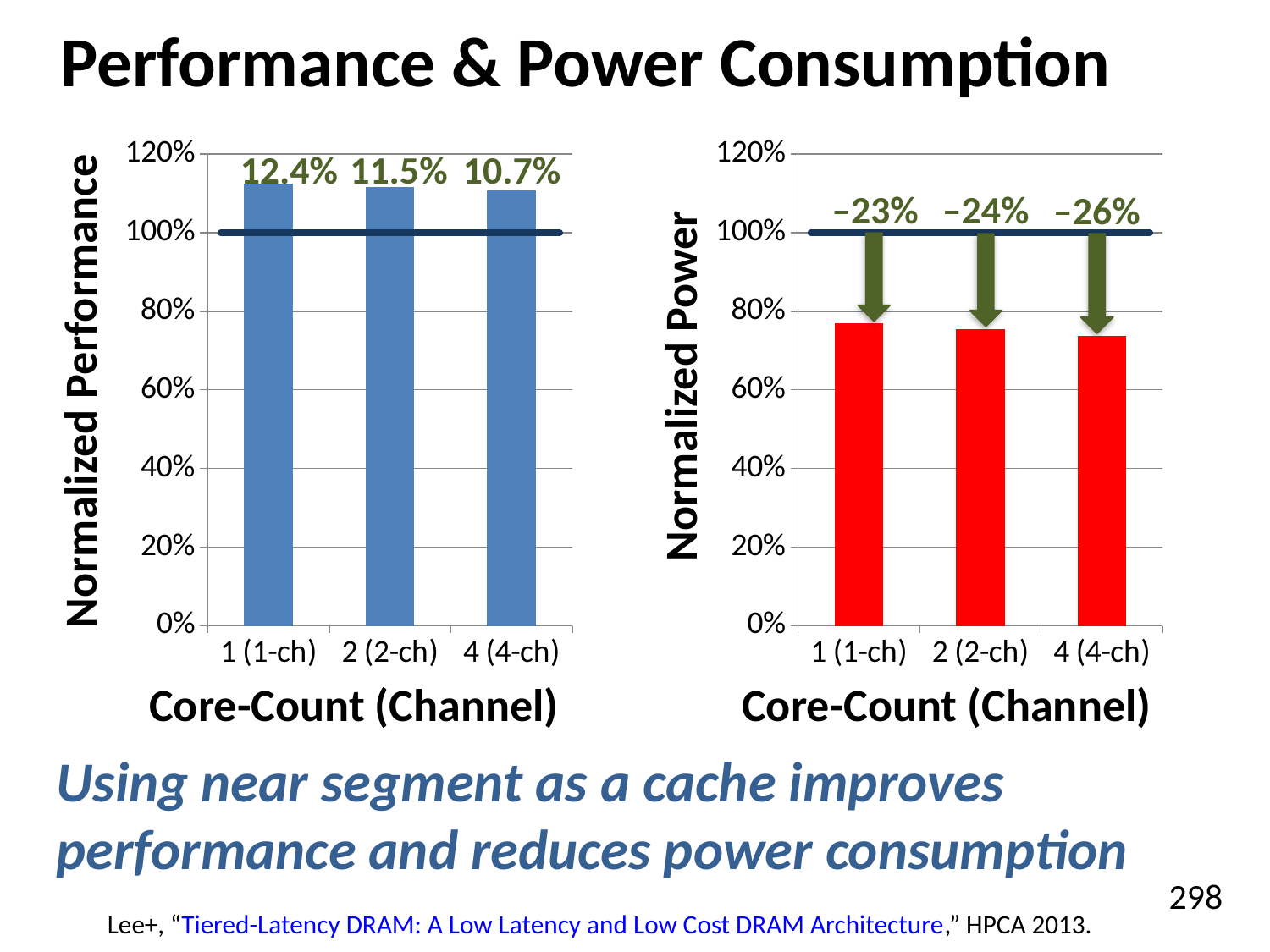
In the Normalized Performance chart, what improvement is labelled above the bar for 1 (1-ch)? 12.4% What kind of chart is the Normalized Performance chart? Bar chart In the Normalized Power chart, is the bar for 1 (1-ch) greater or less than 80%? less In the Normalized Power chart, what reduction is labelled above the bar for 2 (2-ch)? –24% In the Normalized Performance chart, do the labelled improvements rise or fall as the core count increases? Fall In the Normalized Power chart, which core-count configuration has the largest labelled power reduction? 4 (4-ch) In the Normalized Performance chart, which core-count configuration has the largest labelled performance improvement? 1 (1-ch) In the Normalized Power chart, what reduction is labelled above the bar for 4 (4-ch)? –26% In the Normalized Performance chart, what is the difference between the labelled improvements for 1 (1-ch) and 4 (4-ch)? 1.7 percentage points In the Normalized Performance chart, is the bar for 2 (2-ch) greater or less than 100%? greater In the Normalized Performance chart, what improvement is labelled above the bar for 4 (4-ch)? 10.7% How many core-count configurations are shown on the x axis of the Normalized Power chart? 3